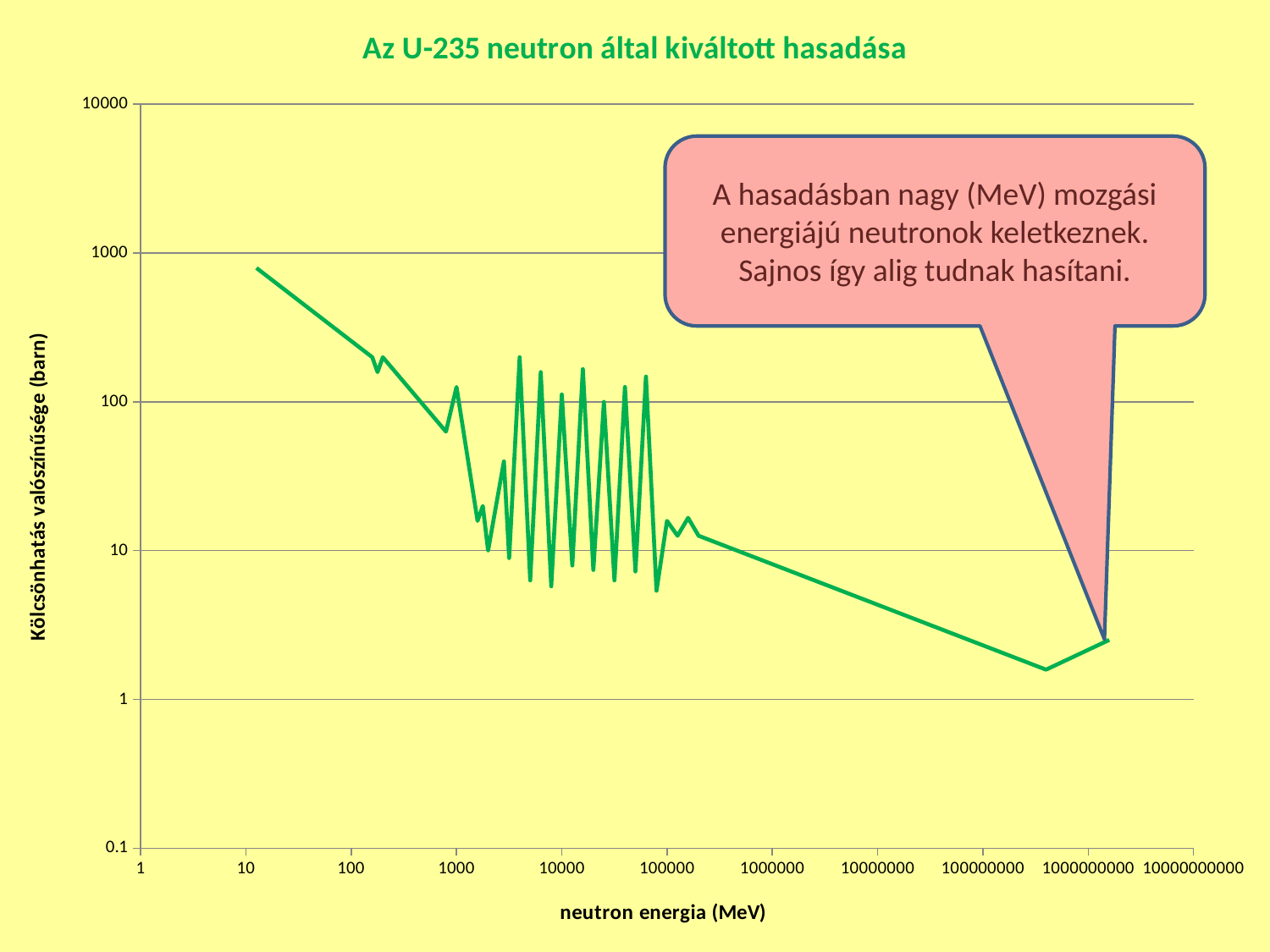
How many data series are plotted on the chart? 1 What is the highest tick value shown on the y axis? 10000 Is the value at a neutron energy of 10 MeV larger or smaller than the value at 1000000 MeV? larger Is the lowest value of the line greater or less than 1 barn? greater Overall, do the values rise or fall as neutron energy increases along the x axis? fall Is the value at a neutron energy of 1000000 MeV greater or less than 10 barn? less What is the label of the x axis? neutron energia (MeV) Is the value at a neutron energy of 10 MeV greater or less than 100 barn? greater What is the title of the chart? Az U-235 neutron által kiváltott hasadása What kind of chart is shown on the slide? line chart What is the lowest tick value shown on the y axis? 0.1